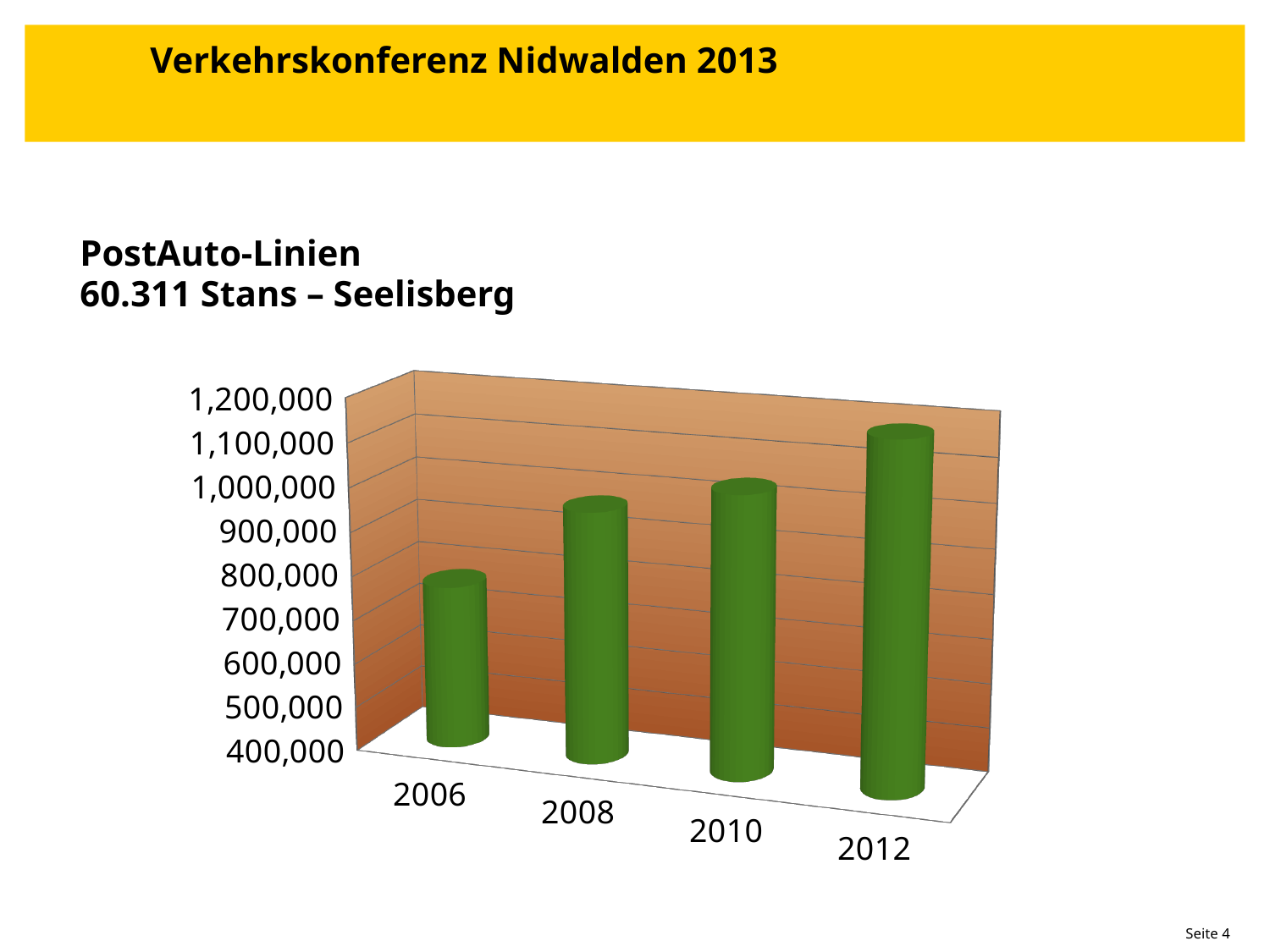
Is the value for 2008 greater or less than 800,000? greater Which year has the highest value in the chart? 2012 Do the values rise or fall from 2006 to 2012? rise What kind of chart is shown on the slide? bar chart Which year has the lowest value in the chart? 2006 Is the value for 2006 greater or less than 600,000? greater How many years are shown on the x axis of the chart? 4 Which is larger, the value for 2012 or the value for 2006? 2012 Which PostAuto line does the chart refer to? 60.311 Stans – Seelisberg Which is larger, the value for 2008 or the value for 2006? 2008 Is the value for 2012 greater or less than 1,000,000? greater